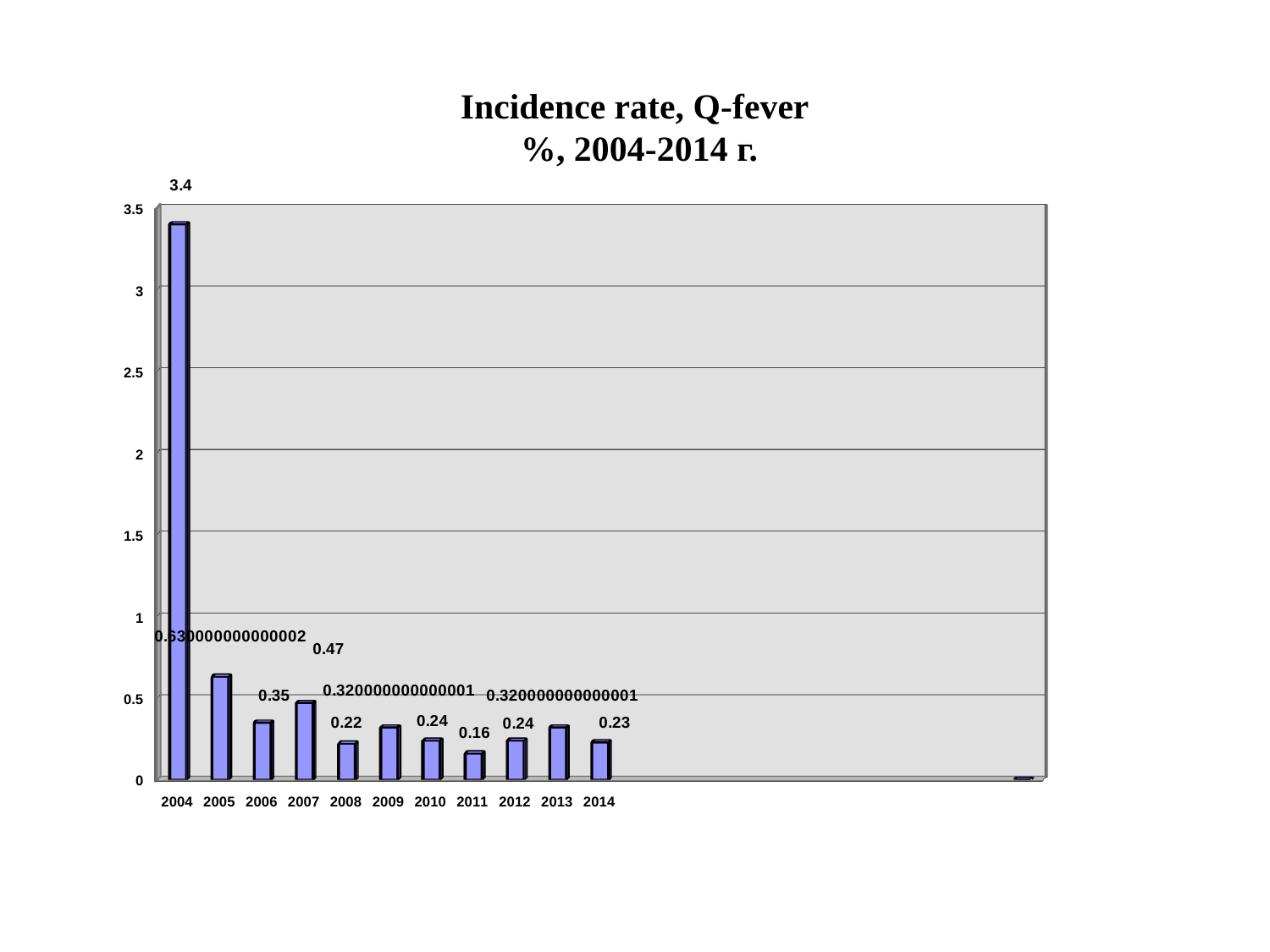
Which year has the highest incidence rate? 2004 Which is larger, the value for 2010 or the value for 2011? 2010 What kind of chart is this? bar chart How many years are shown on the x axis? 11 What is the value for 2014? 0.23 What is the value for 2004? 3.4 What is the value for 2011? 0.16 Which year has the lowest incidence rate? 2011 Is the value for 2004 greater or less than 3? greater What is the title of the chart? Incidence rate, Q-fever %, 2004-2014 г. What is the value for 2007? 0.47 What is the difference between the values for 2004 and 2007? 2.93